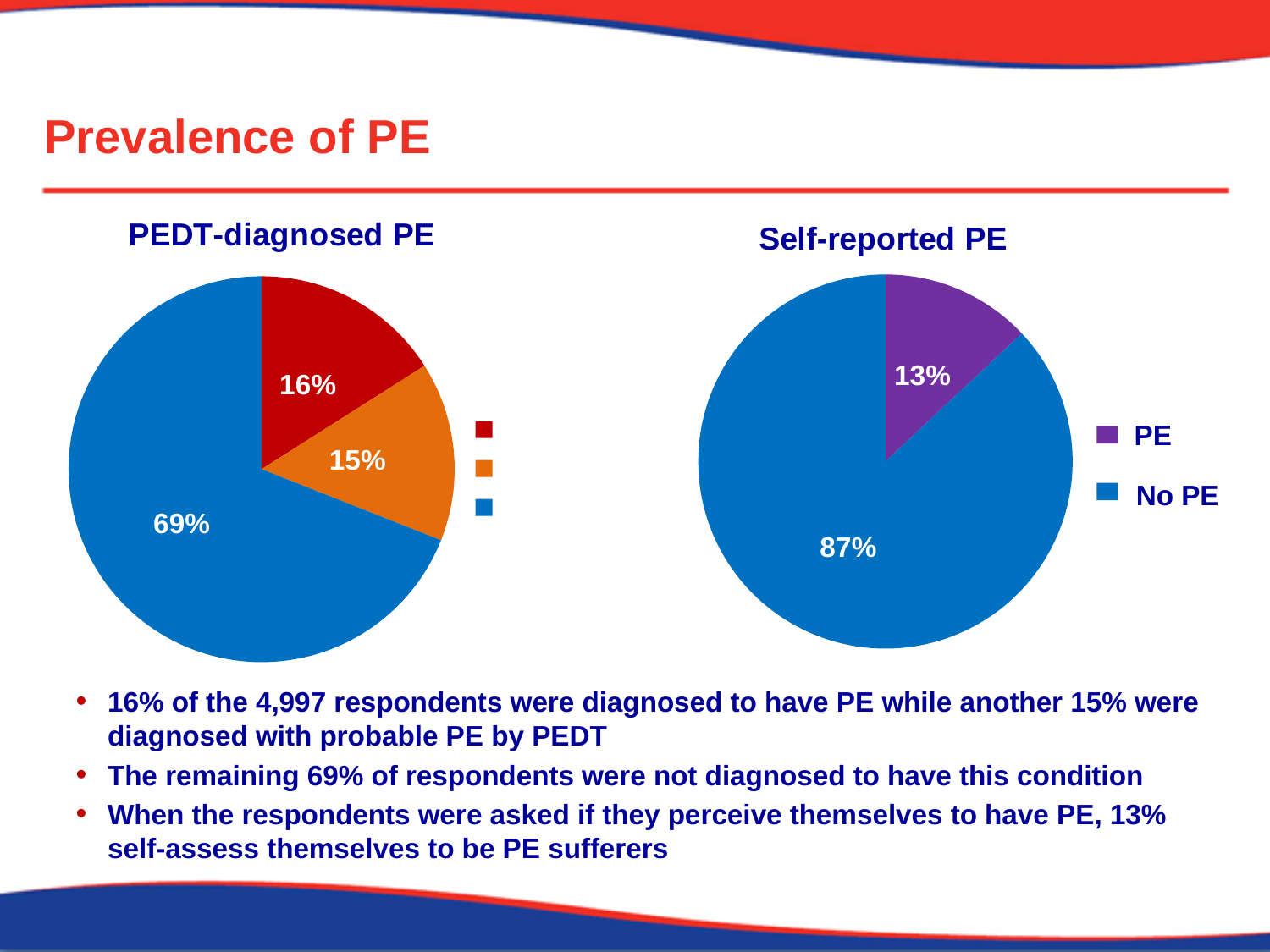
In the PEDT-diagnosed PE pie chart, what is the value of the red slice? 16% How many entries does the legend of the Self-reported PE chart list? 2 How many slices does the PEDT-diagnosed PE pie chart have? 3 In the Self-reported PE pie chart, what share of respondents reported PE? 13% In the PEDT-diagnosed PE pie chart, is the red slice or the orange slice larger? Red slice In the PEDT-diagnosed PE pie chart, what is the value of the largest slice? 69% In the Self-reported PE pie chart, what share of respondents reported No PE? 87% In the Self-reported PE pie chart, which category has the largest slice? No PE In the Self-reported PE pie chart, which category has the smallest slice? PE In the Self-reported PE pie chart, what is the difference between the No PE and PE shares? 74% What type of chart is the PEDT-diagnosed PE chart? Pie chart In the PEDT-diagnosed PE pie chart, what is the value of the orange slice? 15%